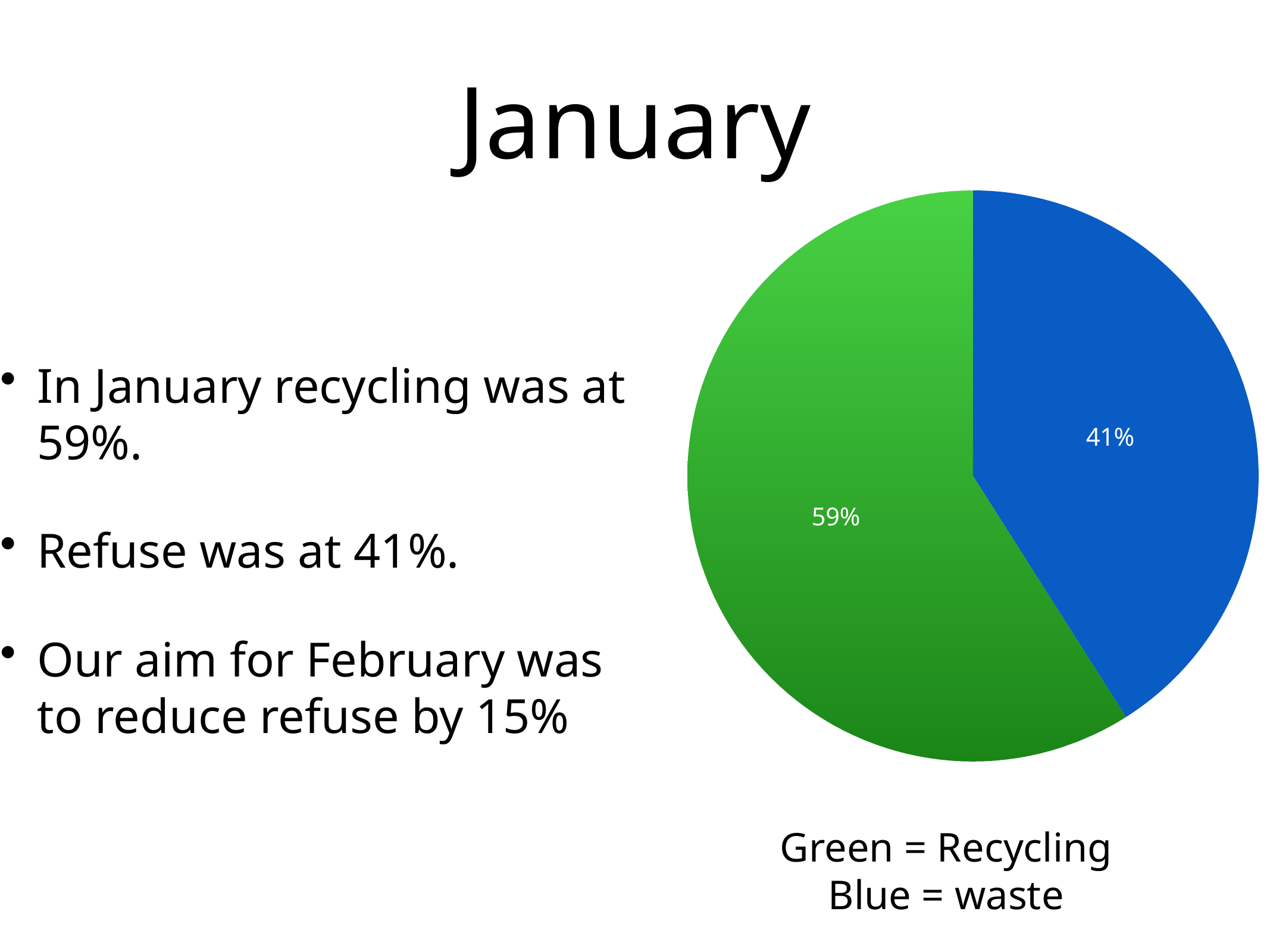
What kind of chart is shown on the slide? pie chart Which is larger, the Recycling slice or the waste slice? Recycling According to the key below the chart, what does the blue colour represent? waste What share of the pie does the blue (waste) slice represent? 41% How many slices does the pie chart have? 2 What is the total of the two slice percentages shown on the pie chart? 100% What is the difference in percentage points between the Recycling slice and the waste slice? 18 According to the key below the chart, what does the green colour represent? Recycling Which slice of the pie is the largest? Recycling (green) What share of the pie does the green (Recycling) slice represent? 59% Which slice of the pie is the smallest? waste (blue)